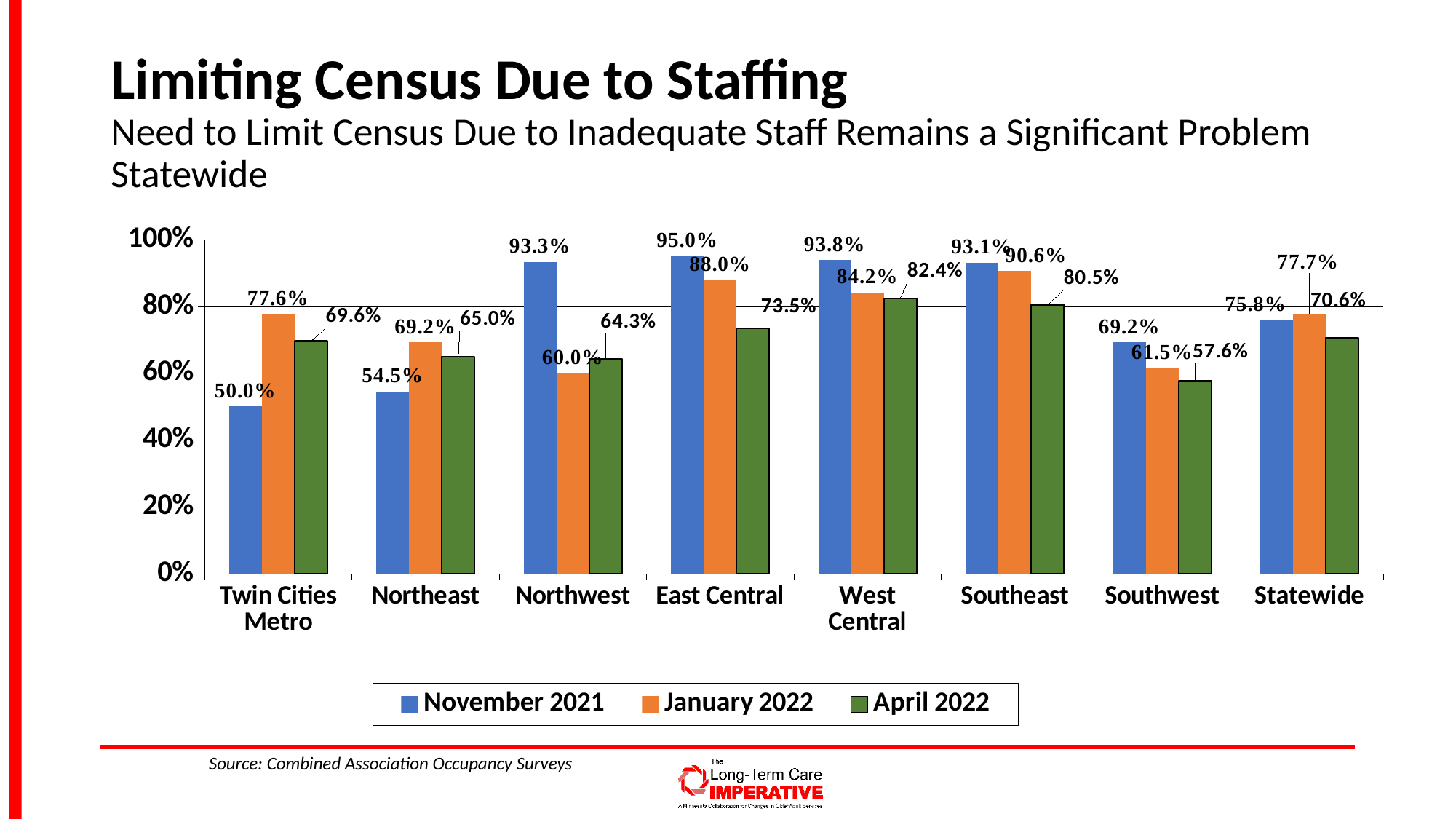
How many regions (categories) are shown on the x axis? 8 What kind of chart is shown on the slide? Bar chart What is the January 2022 value for Southwest? 61.5% Which is larger for Twin Cities Metro: the January 2022 value or the April 2022 value? January 2022 Which region has the lowest November 2021 value? Twin Cities Metro What is the November 2021 value for East Central? 95.0% How many series does the legend list? 3 What is the difference between the November 2021 and January 2022 values for Northwest? 33.3% What is the Statewide value for January 2022? 77.7% Which region has the highest November 2021 value? East Central Which colour represents April 2022 in the legend? Green What is the April 2022 value for Twin Cities Metro? 69.6%